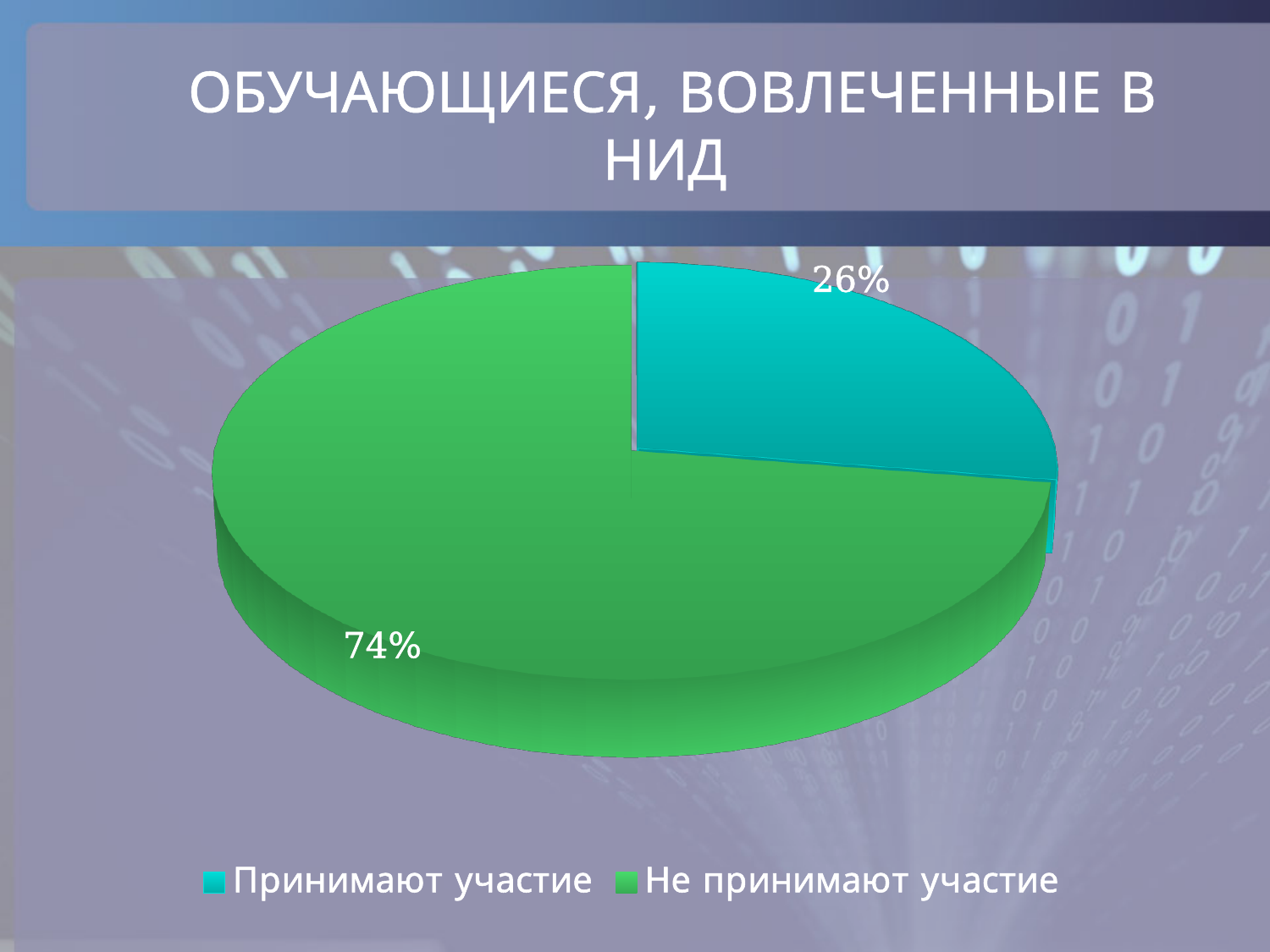
What share of the pie is labelled "Принимают участие"? 26% Which slice is the largest? Не принимают участие What share of the pie is labelled "Не принимают участие"? 74% What is the difference in percentage points between "Не принимают участие" and "Принимают участие"? 48 What kind of chart is shown on the slide? pie chart How many entries does the legend list? 2 What is the title of the slide containing the chart? ОБУЧАЮЩИЕСЯ, ВОВЛЕЧЕННЫЕ В НИД Which is larger: "Принимают участие" or "Не принимают участие"? Не принимают участие What colour is the "Принимают участие" slice? teal (cyan) Which slice is the smallest? Принимают участие How many slices does the pie chart have? 2